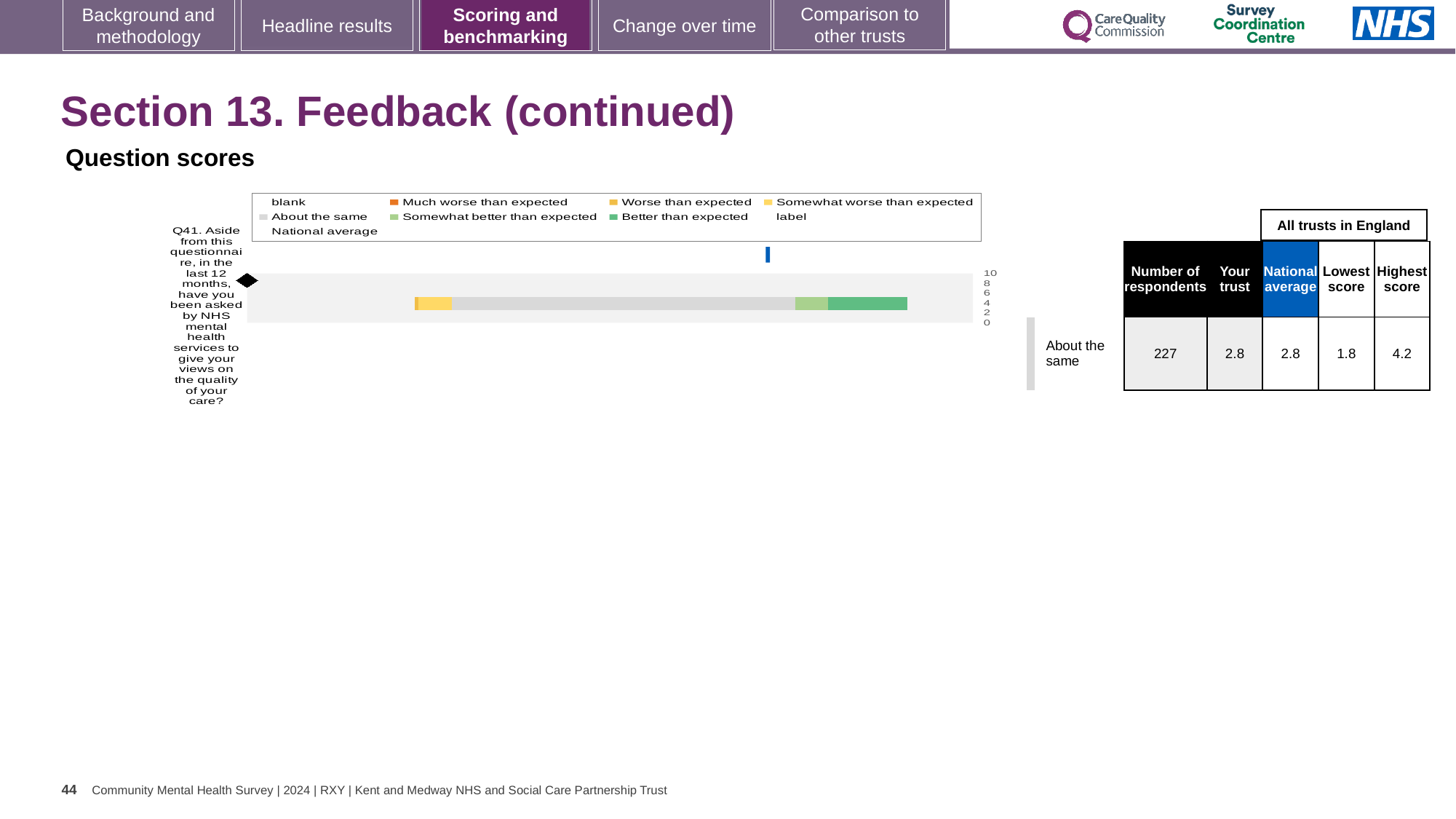
What is the lowest score among all trusts in England for Q41? 1.8 What is the difference between the highest score and the lowest score for Q41? 2.4 What is the 'Your trust' score for Q41? 2.8 What is the highest score among all trusts in England for Q41? 4.2 How many respondents answered Q41? 227 What is the national average score for Q41? 2.8 What does the dark green segment in the legend represent? Better than expected Is the 'Your trust' score for Q41 greater or less than 2? greater How many survey questions are plotted on the chart? 1 Which is larger for Q41, the highest score or the national average? highest score Which benchmark category does the trust's Q41 result fall into? About the same What kind of chart is used to show the Q41 question score? bar chart